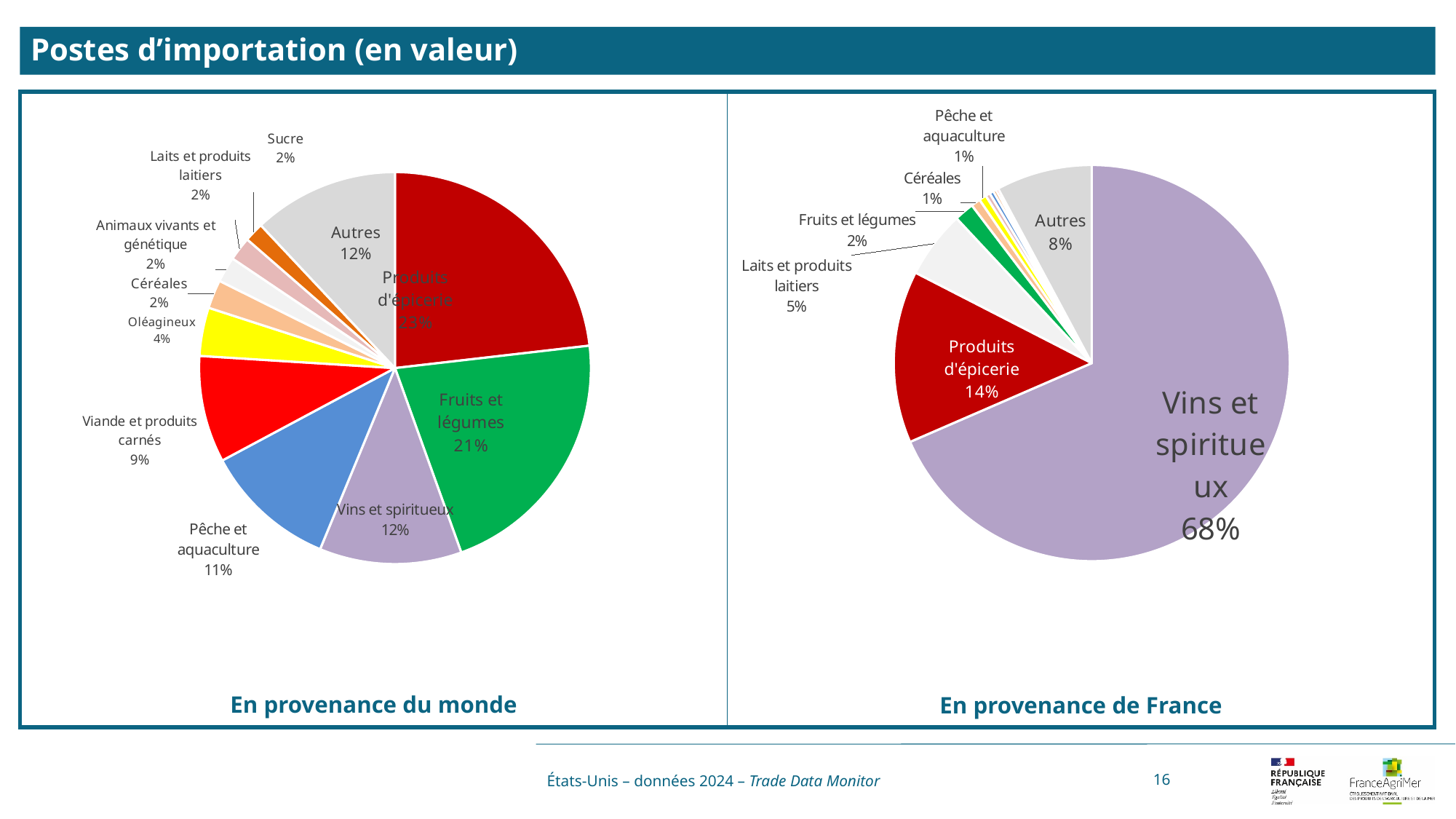
On the 'En provenance du monde' chart, what share do Fruits et légumes represent? 21% What type of chart is used for 'En provenance de France'? Pie chart On the 'En provenance du monde' chart, which category has the largest share? Produits d'épicerie On the 'En provenance du monde' chart, which is larger: Vins et spiritueux or Oléagineux? Vins et spiritueux On the 'En provenance du monde' chart, what share do Produits d'épicerie represent? 23% On the 'En provenance de France' chart, what share do Vins et spiritueux represent? 68% On the 'En provenance de France' chart, what share do Laits et produits laitiers represent? 5% How many categories are shown on the 'En provenance du monde' pie chart? 11 On the 'En provenance de France' chart, what is the difference between the shares of Produits d'épicerie and Autres? 6 percentage points On the 'En provenance du monde' chart, what is the difference between the shares of Pêche et aquaculture and Viande et produits carnés? 2 percentage points On the 'En provenance de France' chart, which category has the largest share? Vins et spiritueux